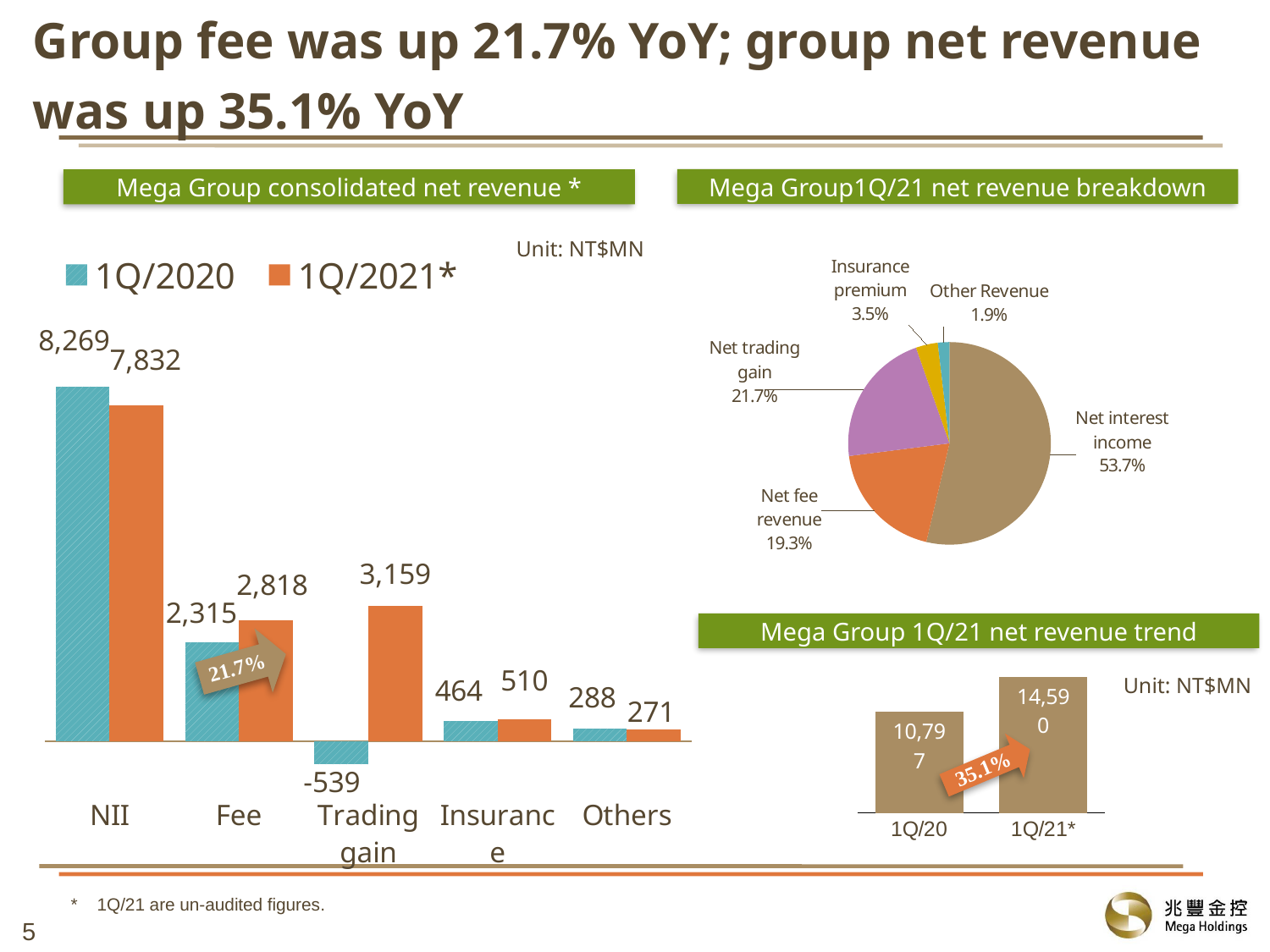
In the 'Mega Group consolidated net revenue' chart, which category has the lowest 1Q/2021* value? Others In the 'Mega Group consolidated net revenue' chart, which is larger for Insurance: the 1Q/2020 value or the 1Q/2021* value? 1Q/2021* What kind of chart is the 'Mega Group 1Q/21 net revenue trend' chart? Bar chart How many categories are shown on the x axis of the 'Mega Group consolidated net revenue' chart? 5 In the 'Mega Group1Q/21 net revenue breakdown' pie chart, what share does Net interest income have? 53.7% In the 'Mega Group consolidated net revenue' chart, what is the difference between the 1Q/2020 and 1Q/2021* values for NII? 437 In the 'Mega Group 1Q/21 net revenue trend' chart, what is the value for 1Q/21*? 14,590 In the 'Mega Group consolidated net revenue' chart, which category has the highest 1Q/2020 value? NII In the 'Mega Group1Q/21 net revenue breakdown' pie chart, which slice is the smallest? Other Revenue In the 'Mega Group consolidated net revenue' chart, what is the 1Q/2021* value for Fee? 2,818 In the 'Mega Group consolidated net revenue' chart, what is the 1Q/2020 value for Trading gain? -539 How many series does the legend of the 'Mega Group consolidated net revenue' chart list? 2